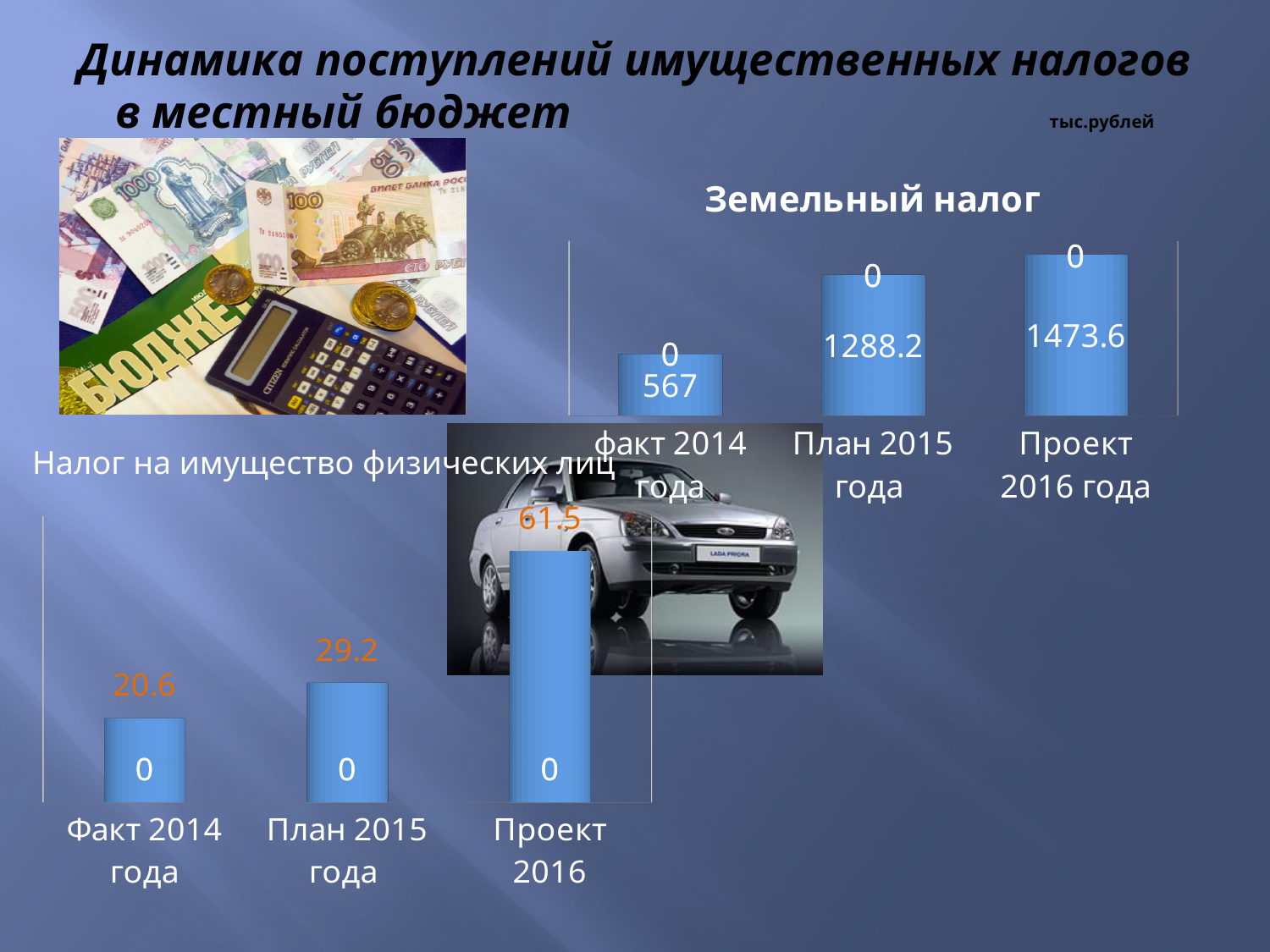
On the 'Налог на имущество физических лиц' chart, which category has the highest value? Проект 2016 On the 'Налог на имущество физических лиц' chart, what is the value for Проект 2016? 61.5 On the 'Земельный налог' chart, what is the difference between Проект 2016 года and План 2015 года? 185.4 On the 'Земельный налог' chart, which category has the highest value? Проект 2016 года How many categories are shown on the 'Земельный налог' chart? 3 On the 'Земельный налог' chart, which category has the lowest value? факт 2014 года On the 'Налог на имущество физических лиц' chart, which is larger: План 2015 года or Проект 2016? Проект 2016 What kind of chart is the 'Налог на имущество физических лиц' chart? Bar chart On the 'Земельный налог' chart, what is the value for факт 2014 года? 567 On the 'Налог на имущество физических лиц' chart, what is the difference between План 2015 года and Факт 2014 года? 8.6 On the 'Земельный налог' chart, what is the value for План 2015 года? 1288.2 On the 'Налог на имущество физических лиц' chart, what is the value for Факт 2014 года? 20.6